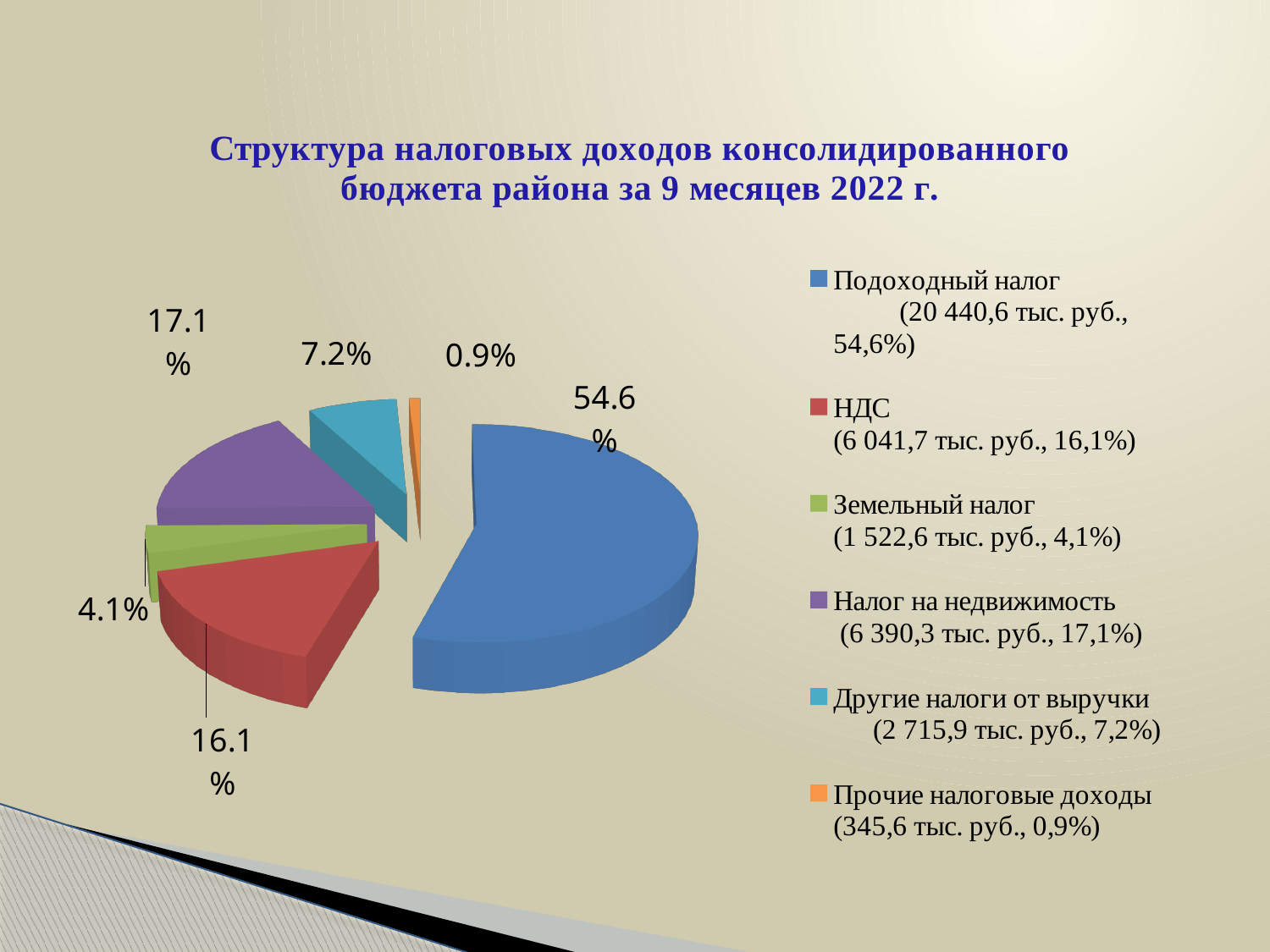
What share of the pie does Налог на недвижимость take? 17.1% What share of the pie does Подоходный налог take? 54.6% According to the legend, what is the amount in thousand rubles for Другие налоги от выручки? 2 715,9 тыс. руб. What kind of chart is shown on the slide? pie chart How many slices does the pie chart have? 6 What is the difference in percentage points between the share for Подоходный налог and the share for НДС? 38.5 Which is larger: the share for НДС or the share for Налог на недвижимость? Налог на недвижимость What share of the pie does НДС take? 16.1% Which category has the largest slice of the pie? Подоходный налог What is the title of the chart? Структура налоговых доходов консолидированного бюджета района за 9 месяцев 2022 г. Which category has the smallest slice of the pie? Прочие налоговые доходы